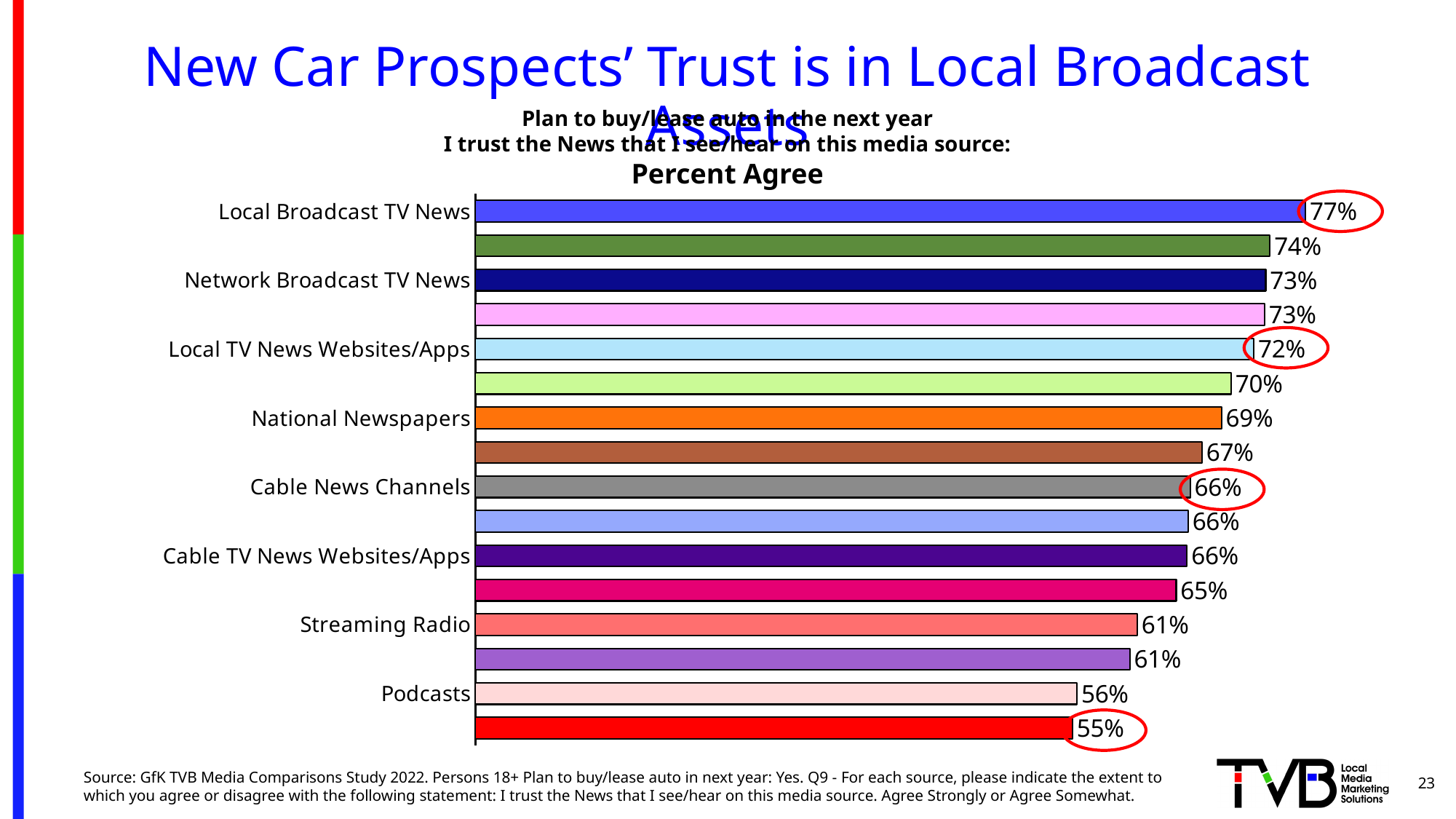
How many bars are plotted on the chart? 16 What is the value for Streaming Radio? 61% What is the value for Local TV News Websites/Apps? 72% What is the lowest value shown on the chart? 55% What is the value for Podcasts? 56% What is the value for National Newspapers? 69% Which is larger, the value for Network Broadcast TV News or the value for National Newspapers? Network Broadcast TV News What kind of chart is shown on the slide? Bar chart What is the value for Network Broadcast TV News? 73% What is the difference between the values for Local Broadcast TV News and Podcasts? 21 percentage points Which media source has the highest percent agree? Local Broadcast TV News What is the value for Local Broadcast TV News? 77%